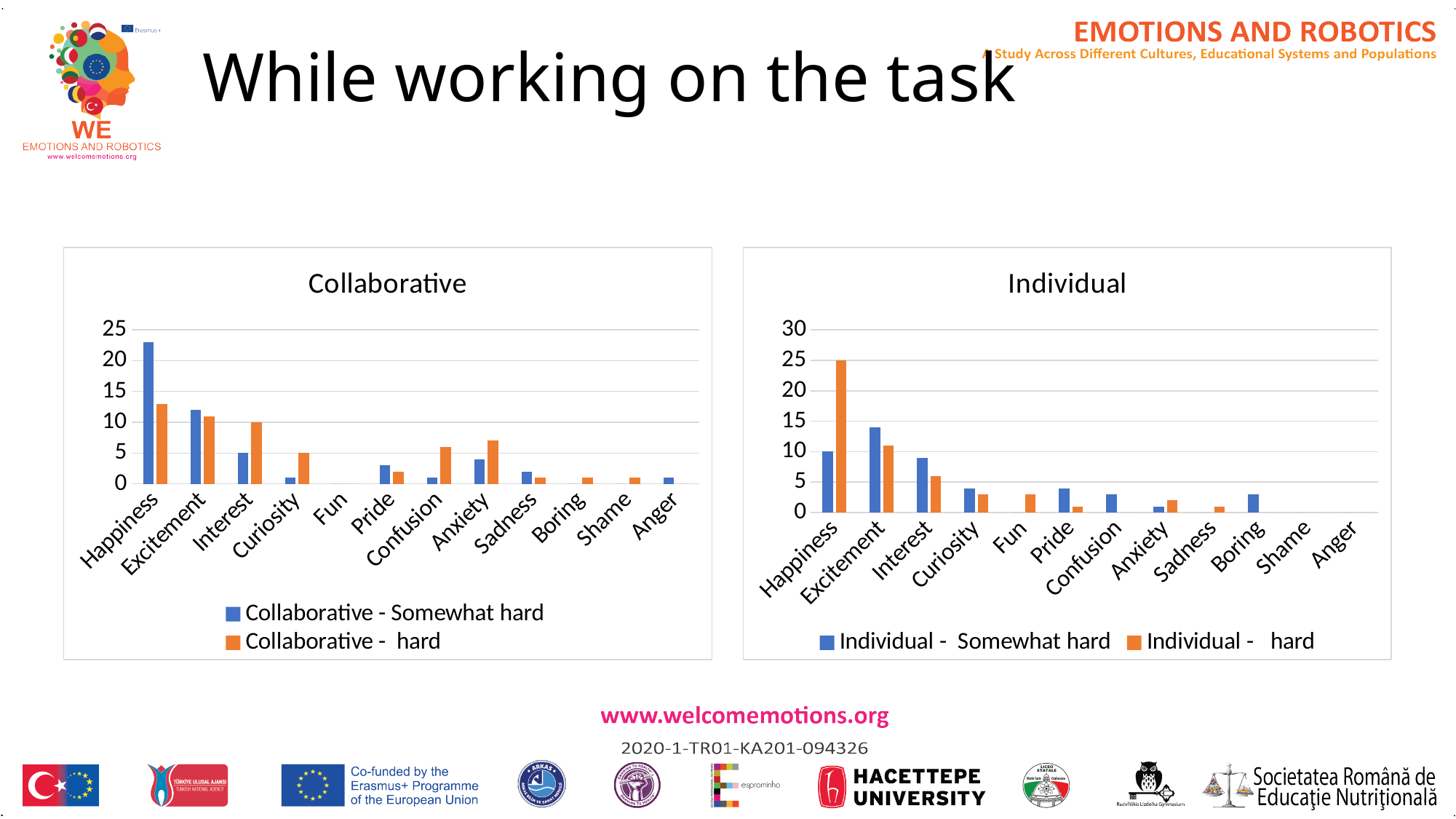
In the "Collaborative" chart, is the "Collaborative - Somewhat hard" value for Happiness greater or less than 20? greater How many emotion categories are shown on the x axis of the "Collaborative" chart? 12 In the "Individual" chart, is the "Individual - Somewhat hard" value for Excitement greater or less than 10? greater In the "Collaborative" chart, which is larger for Anxiety: "Collaborative - Somewhat hard" or "Collaborative - hard"? Collaborative - hard In the "Collaborative" chart, which emotion has the highest "Collaborative - Somewhat hard" value? Happiness In the "Individual" chart, which is larger for Happiness: "Individual - Somewhat hard" or "Individual - hard"? Individual - hard How many series does the legend of the "Individual" chart list? 2 In the "Collaborative" chart, is the "Collaborative - hard" value for Confusion greater or less than 5? greater What colour are the "Individual - hard" bars in the "Individual" chart? orange In the "Individual" chart, which emotion has the highest "Individual - hard" value? Happiness What kind of chart is the "Collaborative" chart? bar chart